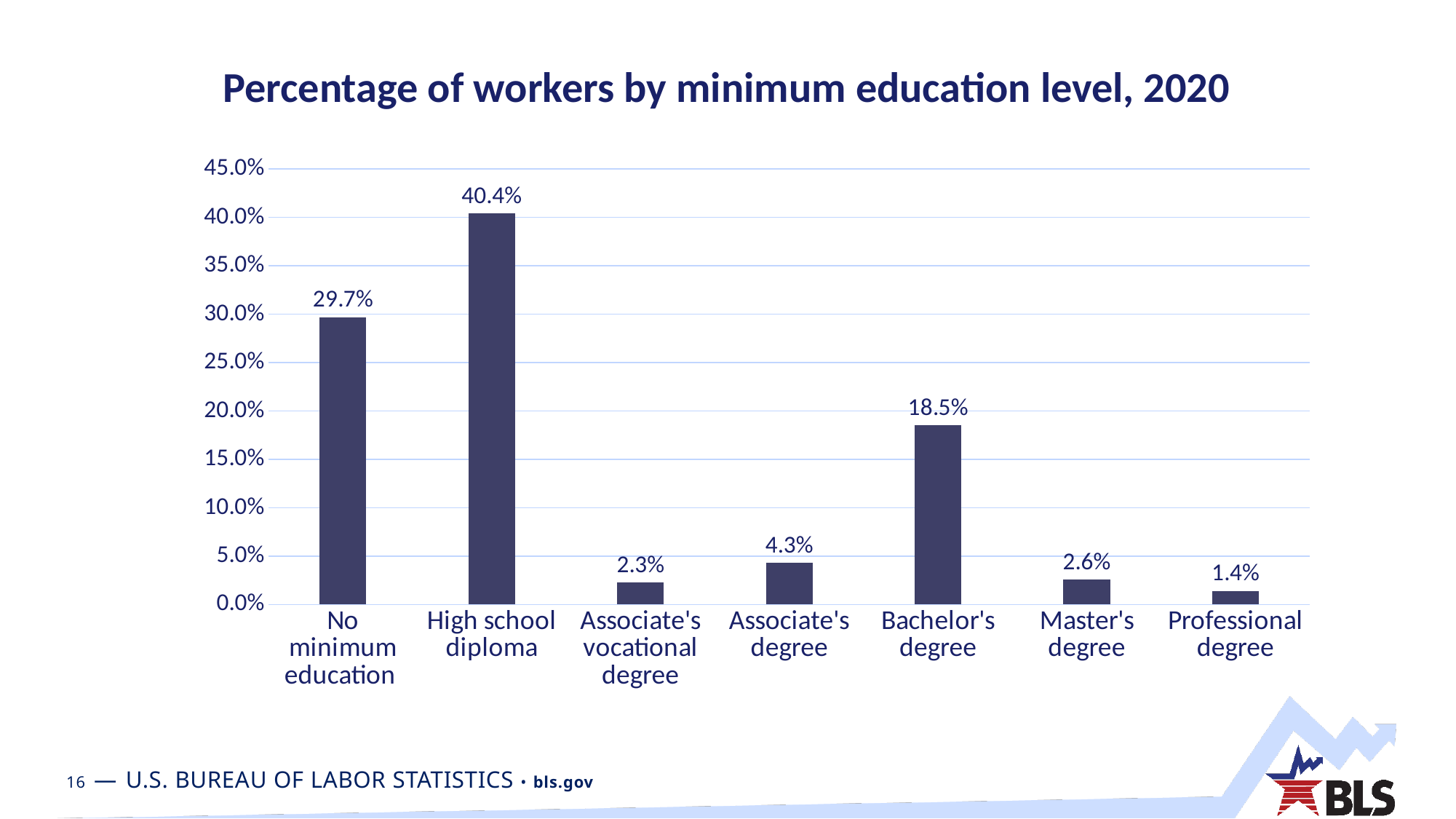
What is the difference between the Associate's degree and Associate's vocational degree values? 2.0% What kind of chart is shown on the slide? Bar chart What is the title of the chart? Percentage of workers by minimum education level, 2020 How many education level categories are shown on the chart? 7 Which is larger, the value for Master's degree or the value for Associate's degree? Associate's degree Which minimum education level has the lowest percentage of workers? Professional degree What is the difference between the High school diploma and No minimum education values? 10.7% Is the value for Bachelor's degree greater or less than 20.0%? less Which minimum education level has the highest percentage of workers? High school diploma What percentage of workers have a high school diploma as the minimum education level? 40.4% What is the value for Bachelor's degree? 18.5% What percentage of workers have no minimum education requirement? 29.7%